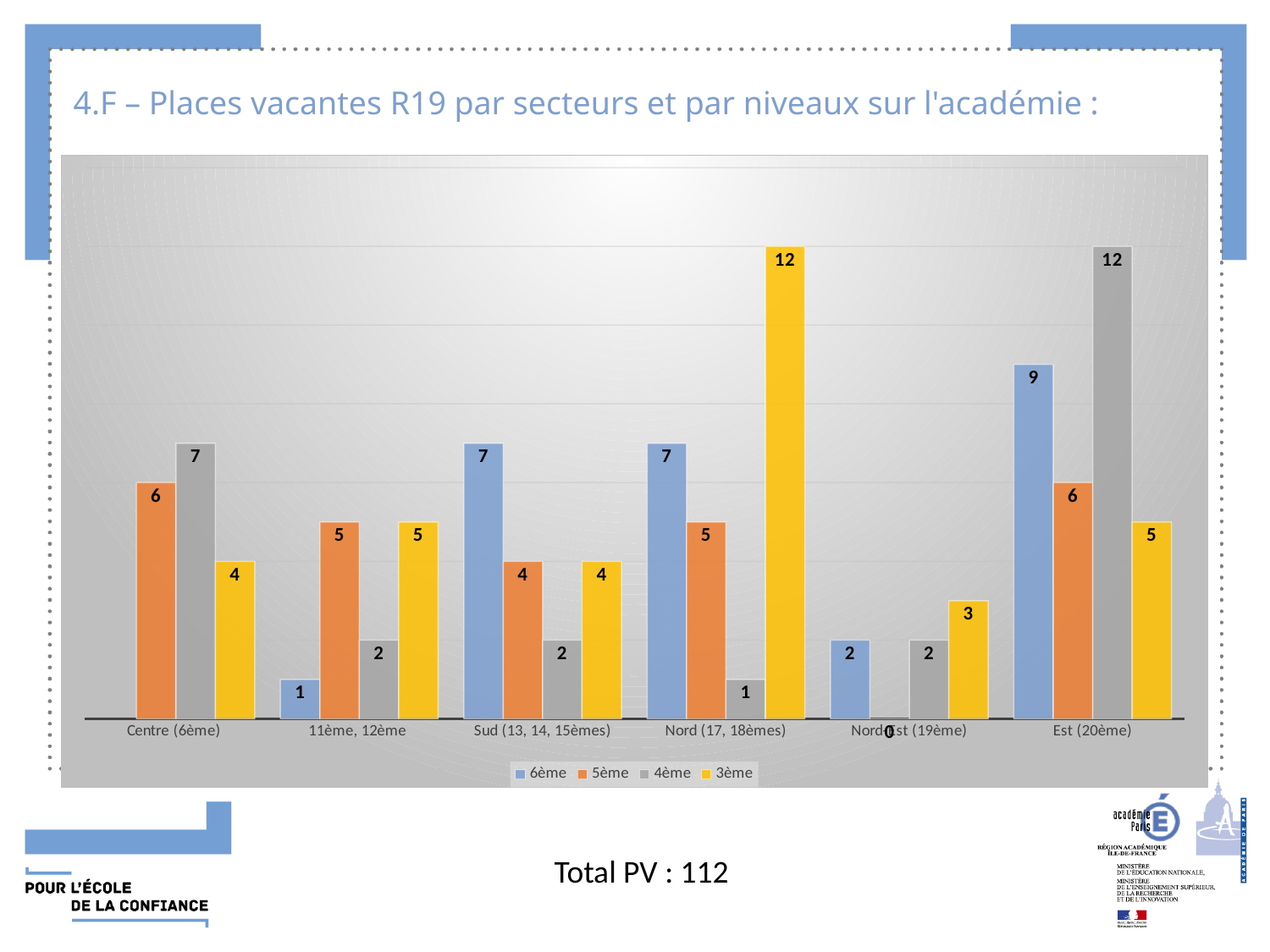
In the Nord (17, 18èmes) category, which is larger: the 6ème value or the 5ème value? 6ème Which category has the highest value for the 6ème series? Est (20ème) What is the value for 3ème in the Nord (17, 18èmes) category? 12 In the Est (20ème) category, what is the difference between the 6ème value and the 5ème value? 3 What kind of chart is shown on the slide? Bar chart What is the value for 6ème in the Sud (13, 14, 15èmes) category? 7 What are the entries listed in the chart legend? 6ème, 5ème, 4ème, 3ème How many categories are shown on the x axis? 6 Which category has the lowest value for the 3ème series? Nord-Est (19ème) What is the value for 5ème in the Centre (6ème) category? 6 What is the value for 4ème in the Est (20ème) category? 12 How many series does the legend list? 4